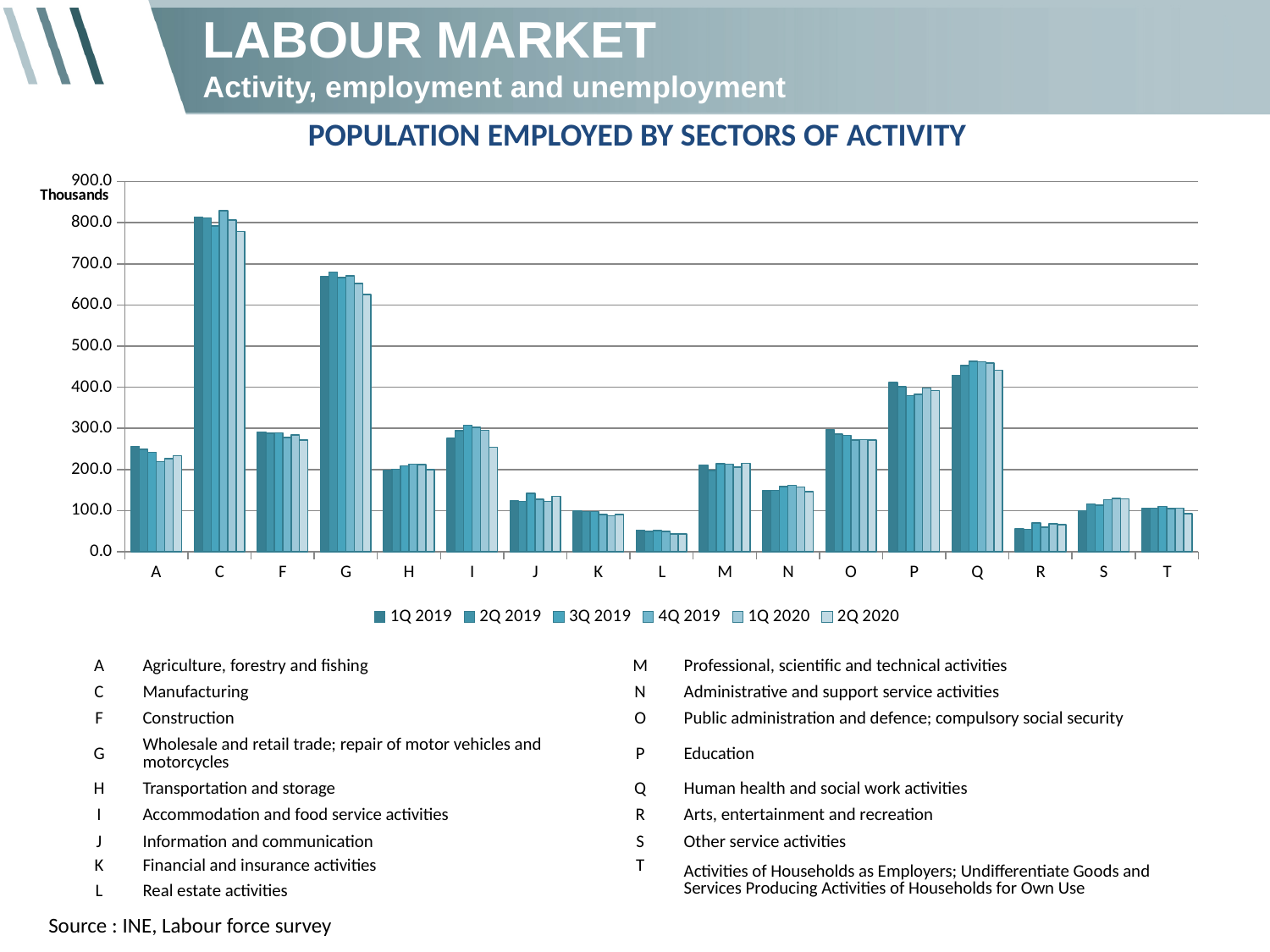
Is the value for sector A in 1Q 2019 greater or less than 200.0? greater Which sector category has the lowest employed population in the chart? L How many series does the chart legend list? 6 Which sector category has the highest employed population in the chart? C What is the title of the chart? POPULATION EMPLOYED BY SECTORS OF ACTIVITY What type of chart is shown on the slide? bar chart Is the value for sector Q in 3Q 2019 greater or less than 400.0? greater Which has the larger value for 1Q 2019, sector G or sector Q? G How many sector categories are shown along the x axis of the chart? 17 Is the value for sector L in 1Q 2019 greater or less than 100.0? less